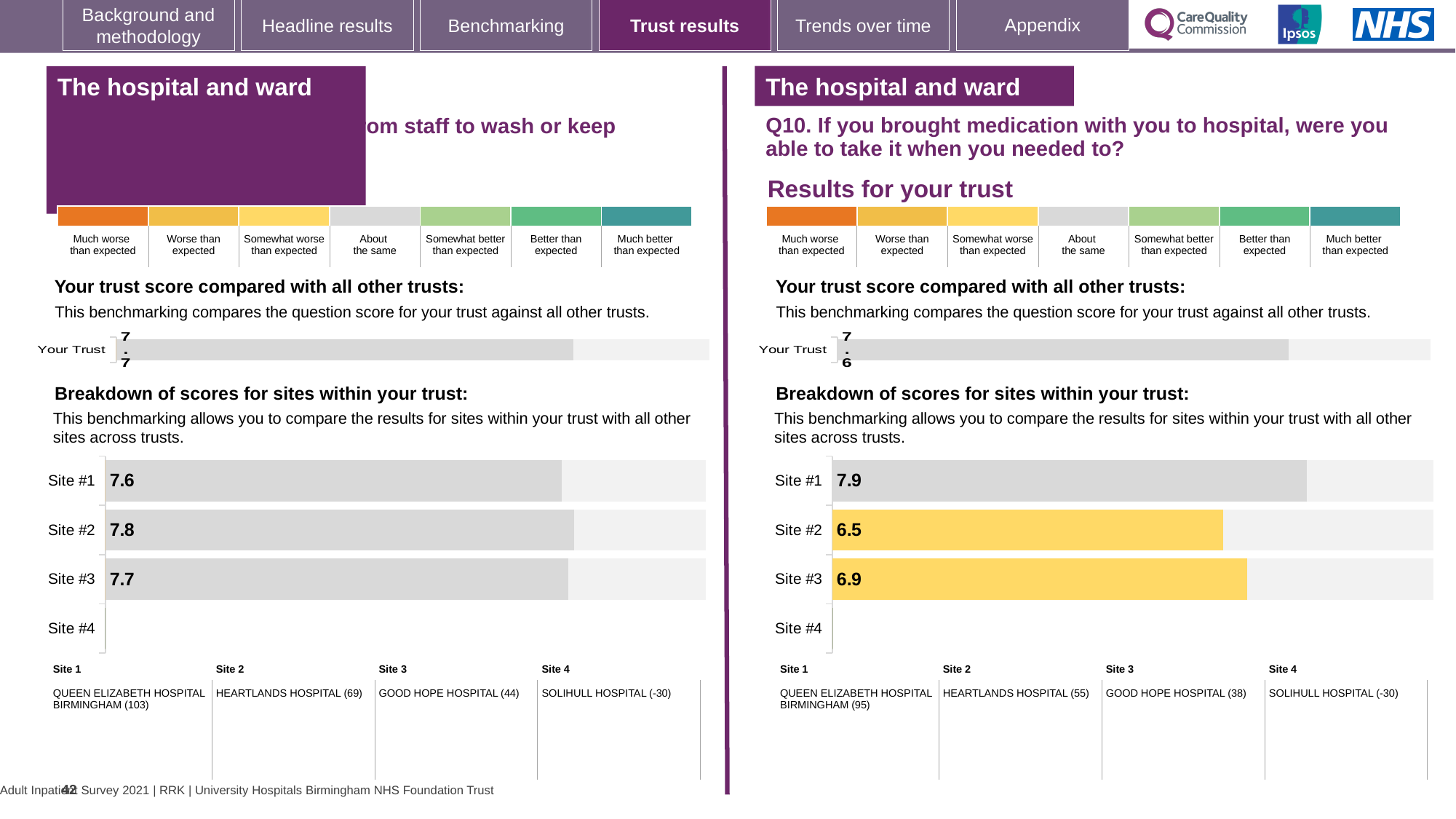
In the left-hand site breakdown chart, what is the score for Site #1? 7.6 In the right-hand site breakdown chart (Q10), what is the score for Site #2? 6.5 What type of chart is used for the site breakdown on the right-hand side of the slide? Bar chart In the left-hand site breakdown chart, what is the difference between the scores for Site #2 and Site #1? 0.2 In the right-hand site breakdown chart (Q10), what is the score for Site #1? 7.9 In the right-hand site breakdown chart (Q10), what is the score for Site #3? 6.9 In the right-hand site breakdown chart (Q10), what is the difference between the scores for Site #1 and Site #2? 1.4 In the right-hand 'Your trust score compared with all other trusts' chart (Q10), what is the score shown for Your Trust? 7.6 In the right-hand site breakdown chart (Q10), which is larger, the score for Site #3 or Site #2? Site #3 In the left-hand site breakdown chart, what is the score for Site #2? 7.8 In the right-hand site breakdown chart (Q10), which site has the highest score? Site #1 In the right-hand site breakdown chart (Q10), which site has the lowest score among those with a bar? Site #2